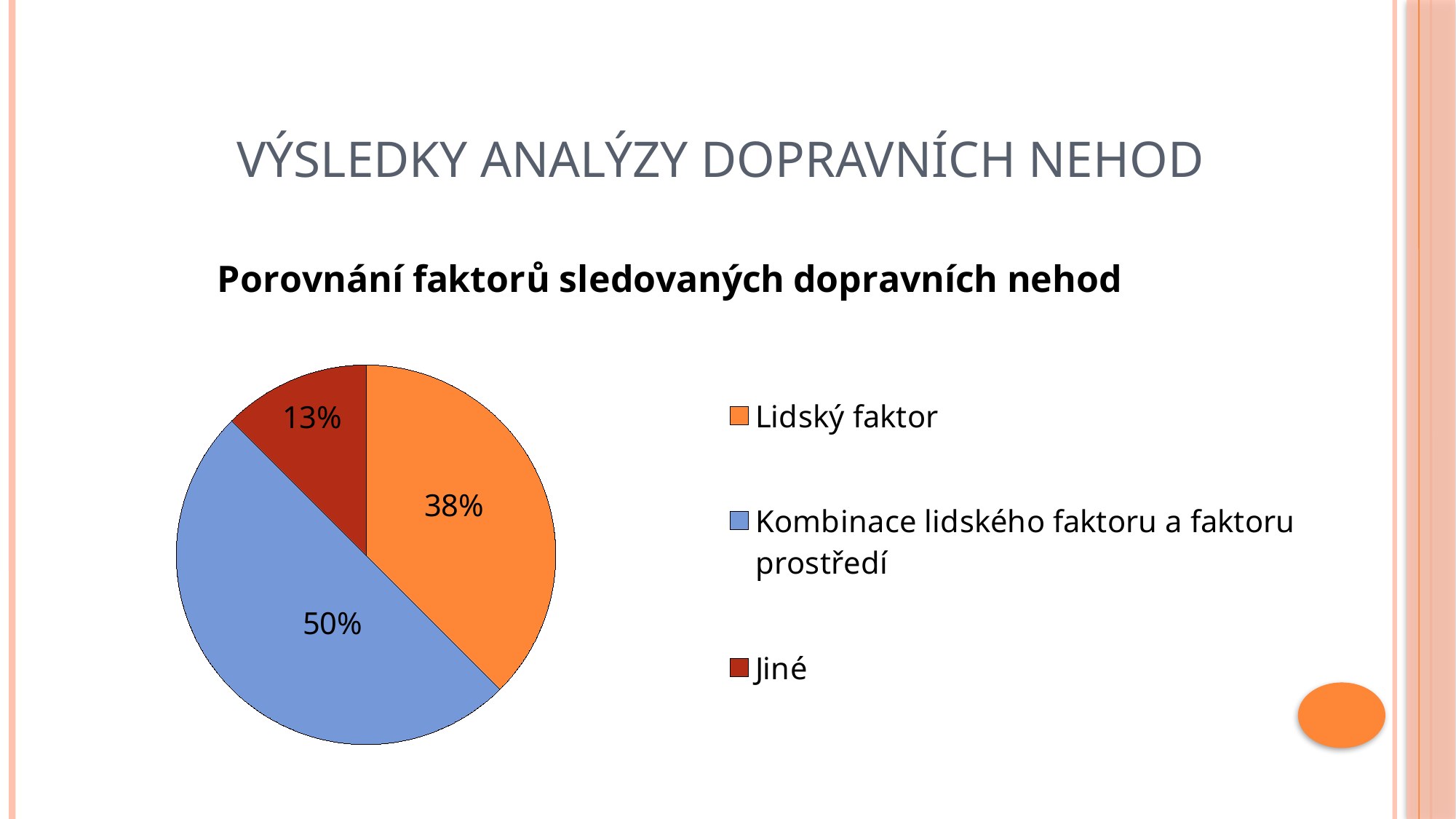
What share of the pie does Kombinace lidského faktoru a faktoru prostředí have? 50% What share of the pie does Jiné have? 13% Which category has the smallest slice of the pie? Jiné How many slices does the pie chart have? 3 What share of the pie does Lidský faktor have? 38% What colour is the slice for Jiné? Dark red What is the difference in percentage points between Lidský faktor and Jiné? 25 What is the title of the chart? Porovnání faktorů sledovaných dopravních nehod Which category has the largest slice of the pie? Kombinace lidského faktoru a faktoru prostředí What kind of chart is shown on the slide? Pie chart Which is larger, the slice for Lidský faktor or the slice for Jiné? Lidský faktor What is the difference in percentage points between Kombinace lidského faktoru a faktoru prostředí and Lidský faktor? 12